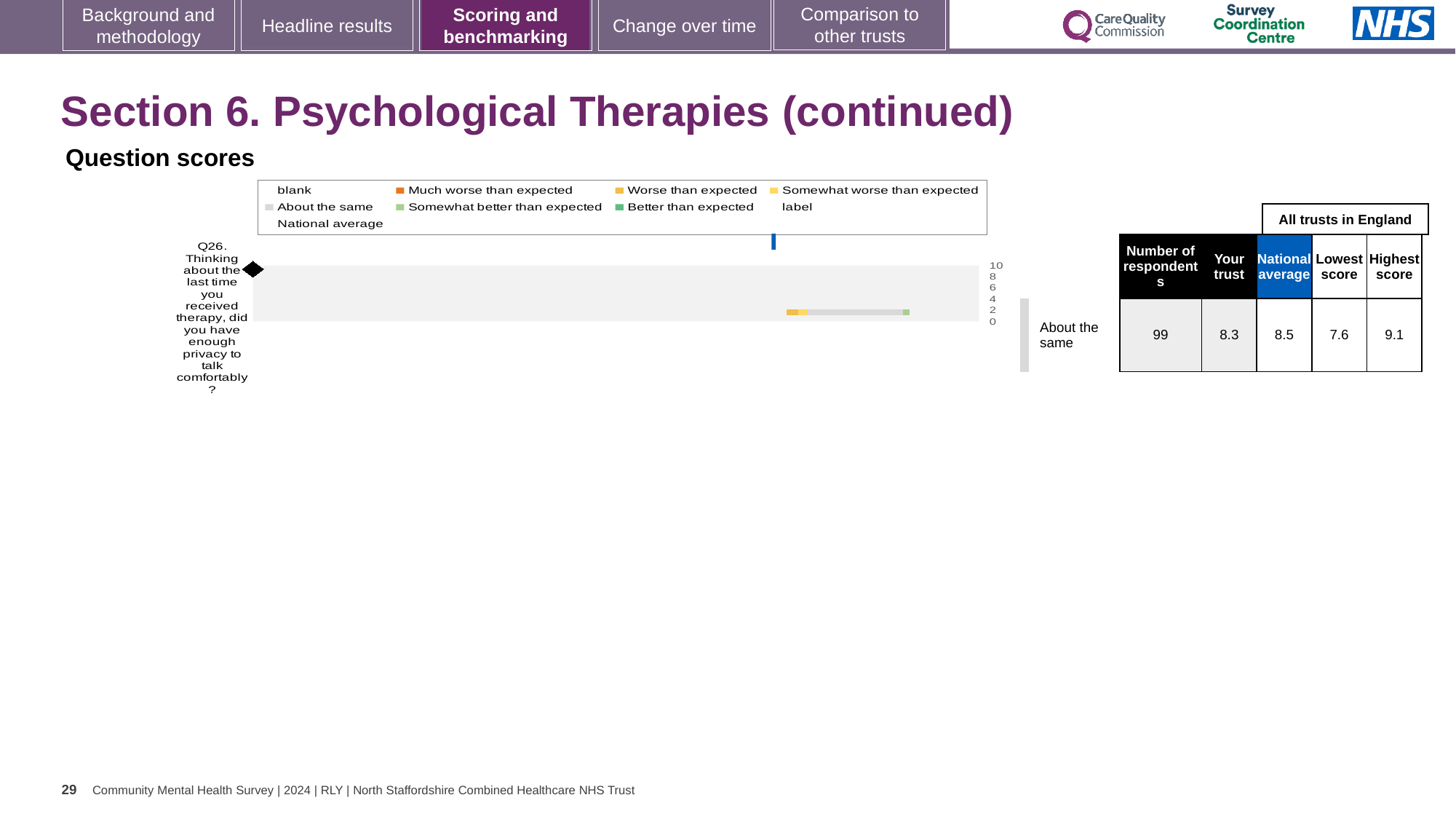
What is the difference between the Highest score and the Lowest score for Q26? 1.5 Which is larger for Q26, the 'Your trust' score or the National average? National average What is the National average score for Q26? 8.5 What is the highest value shown on the chart's axis? 10 What is the Lowest score among all trusts in England for Q26? 7.6 What is the Highest score among all trusts in England for Q26? 9.1 What kind of chart is shown under 'Question scores'? bar chart Which question is plotted in the Question scores chart? Q26. Thinking about the last time you received therapy, did you have enough privacy to talk comfortably? What is the 'Your trust' score for Q26? 8.3 How many respondents answered Q26? 99 How many questions are plotted in the Question scores chart? 1 What benchmark category is Q26 assigned to? About the same